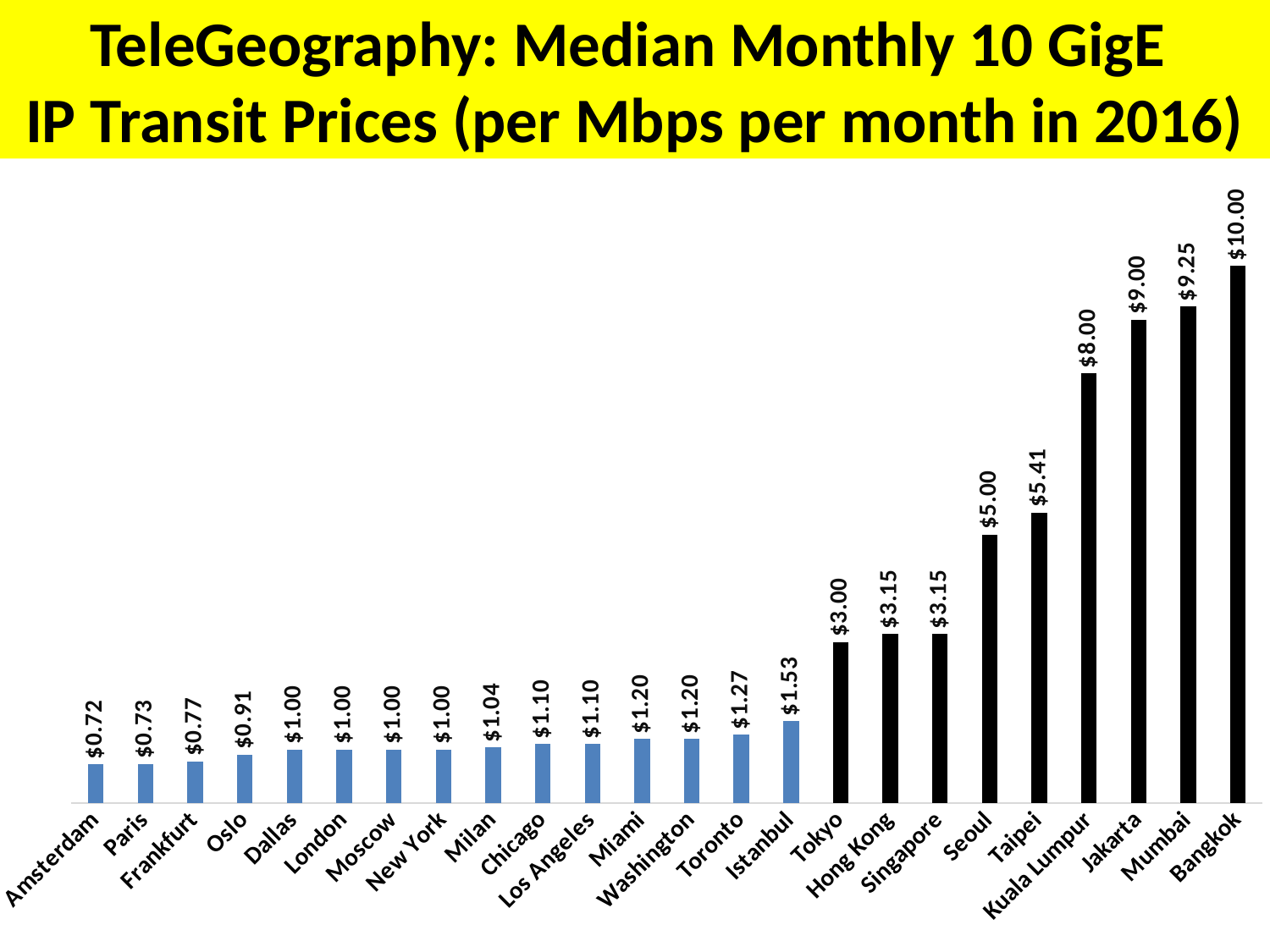
Which is larger, the value for Jakarta or the value for Kuala Lumpur? Jakarta Which city has the lowest median monthly IP transit price? Amsterdam What is the value shown for Kuala Lumpur? $8.00 Do the values rise or fall moving from left to right along the x axis? Rise What is the value shown for Istanbul? $1.53 What is the difference between the values for Bangkok and Mumbai? $0.75 How many cities are shown on the chart? 24 Which city has the highest median monthly IP transit price? Bangkok What is the difference between the values for Taipei and Tokyo? $2.41 What kind of chart is shown on the slide? Bar chart What is the value shown for Seoul? $5.00 What is the median monthly 10 GigE IP transit price for Amsterdam? $0.72